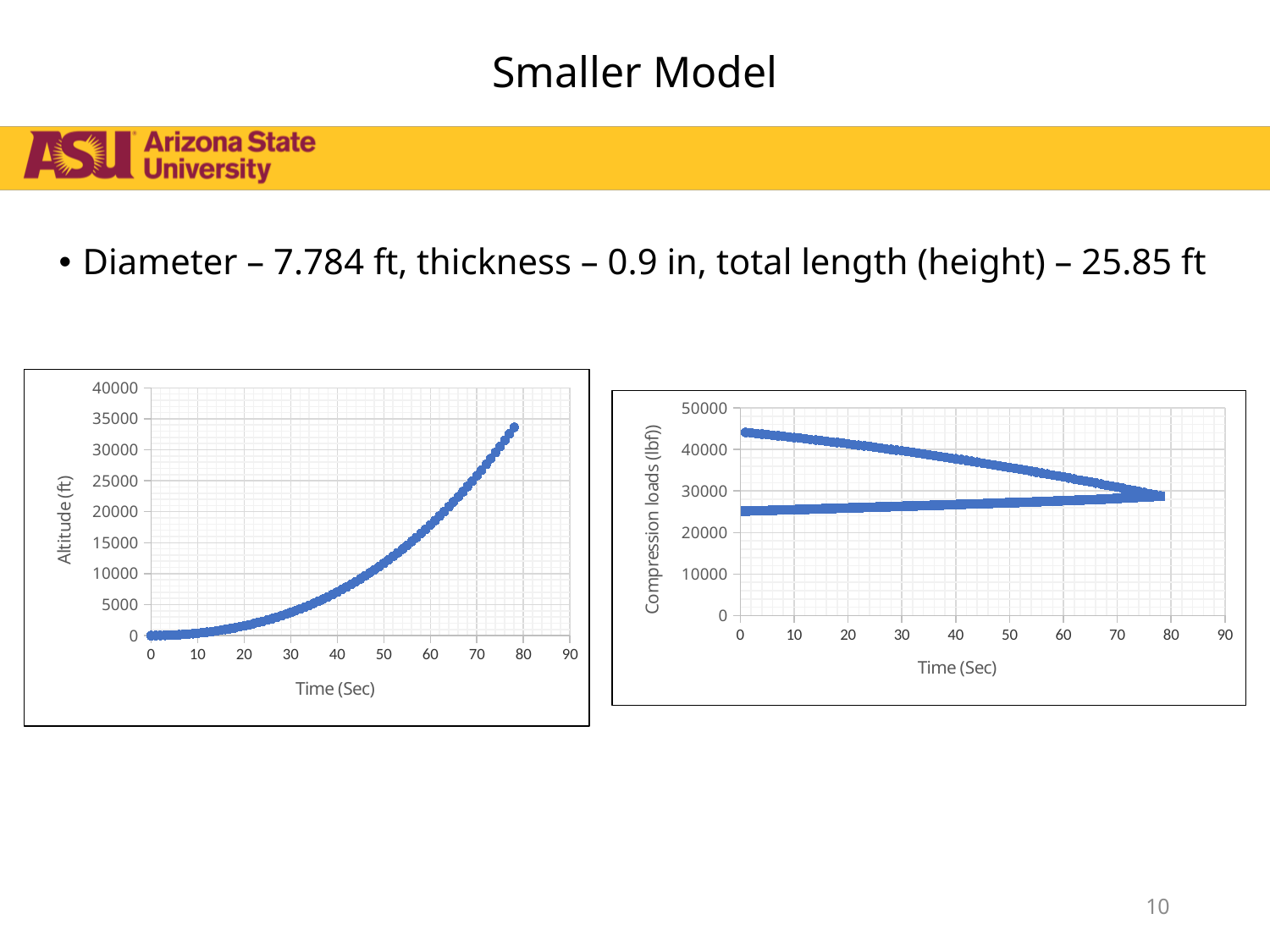
In the left chart, is the altitude at the final time point greater or less than 30000? greater In the right chart, is the compression load at time 0 on the upper branch greater or less than 40000? greater In the right chart, is the compression load at time 0 on the lower branch greater or less than 30000? less In the right chart, does the lower branch of compression loads rise or fall as time increases? rise What kind of chart is the right chart showing Compression loads (lbf) against Time (Sec)? scatter chart What is the y-axis label of the right chart? Compression loads (lbf) In the right chart, does the upper branch of compression loads rise or fall as time increases? fall What kind of chart is the left chart showing Altitude (ft) against Time (Sec)? scatter chart What is the y-axis label of the left chart? Altitude (ft) In the left chart, does altitude rise or fall as time increases? rise